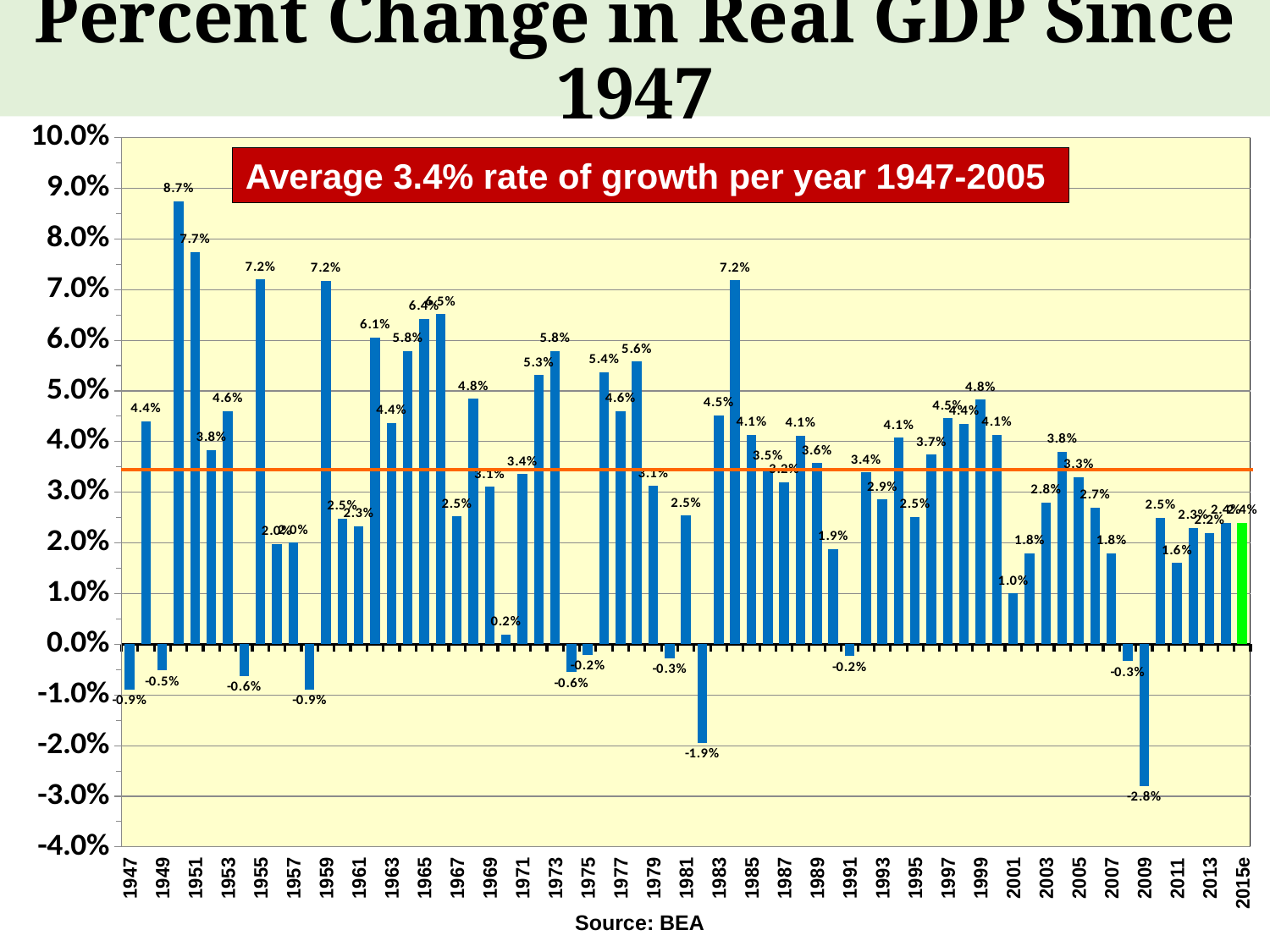
What is the percent change in real GDP for 2009? -2.8% What is the percent change in real GDP for 1950? 8.7% Which year has the lowest percent change in real GDP? 2009 What is the percent change in real GDP for 1982? -1.9% According to the text box on the chart, what was the average rate of growth per year from 1947 to 2005? 3.4% What is the difference in percentage points between the values for 1950 and 1951? 1.0 percentage points Which year has the larger percent change in real GDP, 1972 or 1973? 1973 What source is cited below the chart? BEA Which year has the highest percent change in real GDP? 1950 What is the percent change in real GDP for 1984? 7.2% What kind of chart is shown on the slide? Bar chart What is the percent change in real GDP for 2001? 1.0%